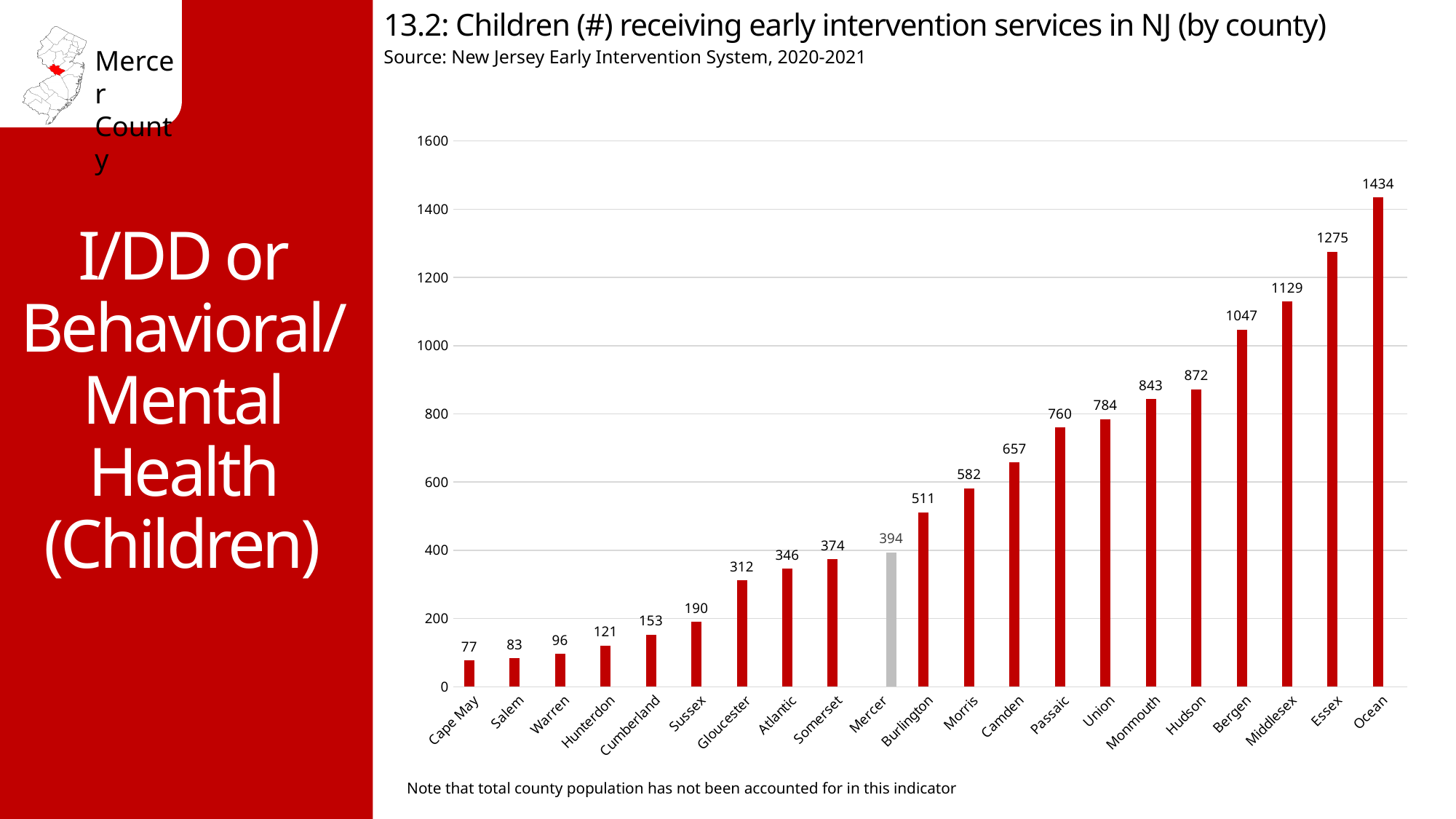
What is the difference between the values for Ocean and Essex? 159 Which county's bar is coloured grey instead of red? Mercer What is the difference between the values for Mercer and Somerset? 20 How many children received early intervention services in Mercer County? 394 How many counties are shown on the chart? 21 Which county has the highest number of children receiving early intervention services? Ocean Do the values rise or fall moving from left to right along the x axis? Rise What is the value shown for Camden? 657 What type of chart is shown on the slide? Bar chart Which county has the lowest number of children receiving early intervention services? Cape May Is the value for Passaic greater or less than 800? less Which county has a larger value, Bergen or Hudson? Bergen